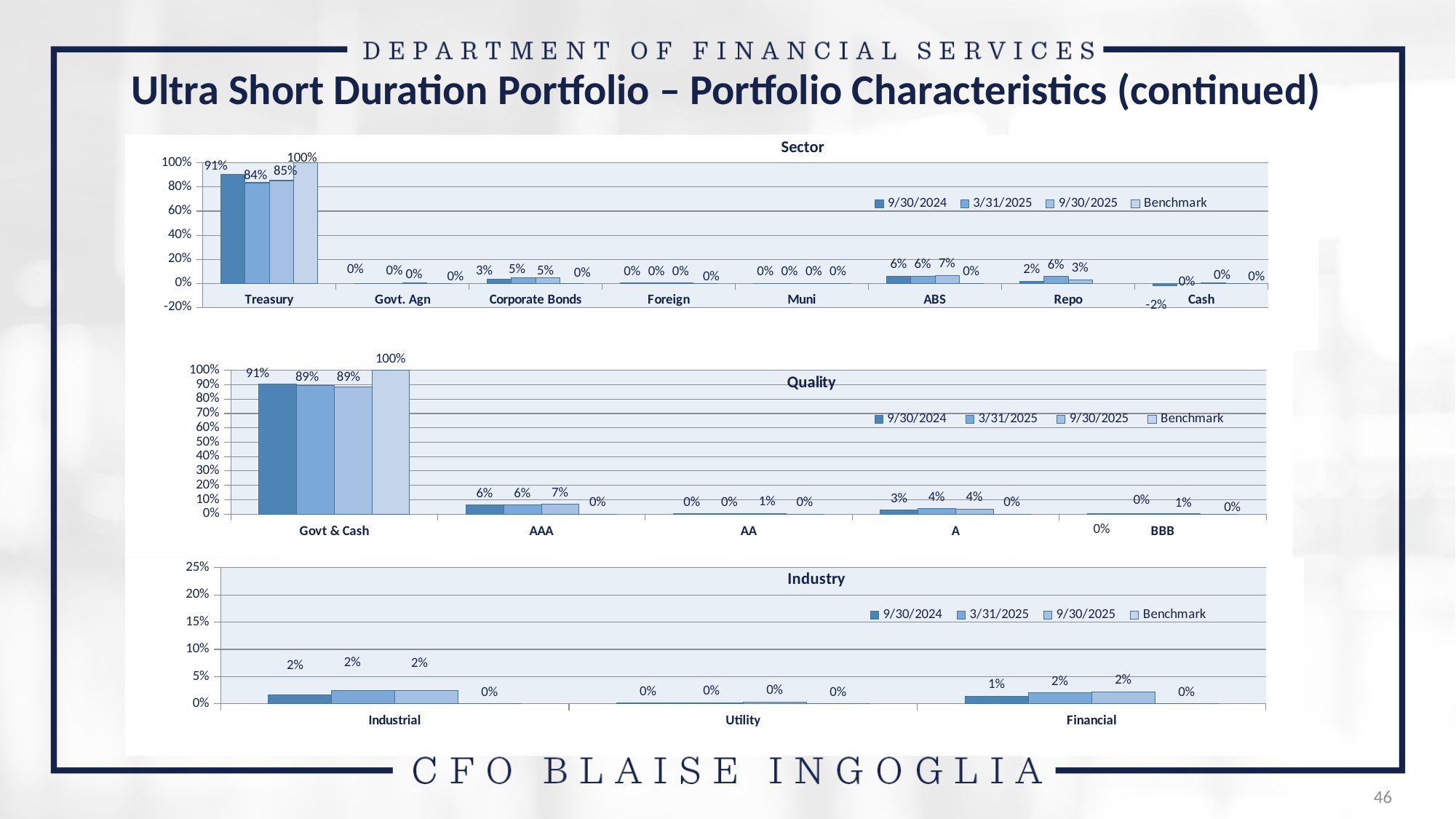
In the Industry chart, what is the Financial value for 9/30/2024? 1% In the Quality chart, what is the Govt & Cash value for 3/31/2025? 89% In the Sector chart, what is the difference between the Repo values for 3/31/2025 and 9/30/2025? 3% In the Quality chart, which category has the highest value for 9/30/2025? Govt & Cash In the Quality chart, what is the value for A on 9/30/2024? 3% In the Sector chart, what is the Treasury value for 9/30/2024? 91% What kind of chart is the Industry chart? Bar chart In the Sector chart, what is the Benchmark value for Treasury? 100% In the Industry chart, how many industry categories are shown? 3 In the Sector chart, how many sector categories are shown on the x axis? 8 In the Quality chart, how many series does the legend list? 4 In the Sector chart, what is the Cash value for 9/30/2024? -2%